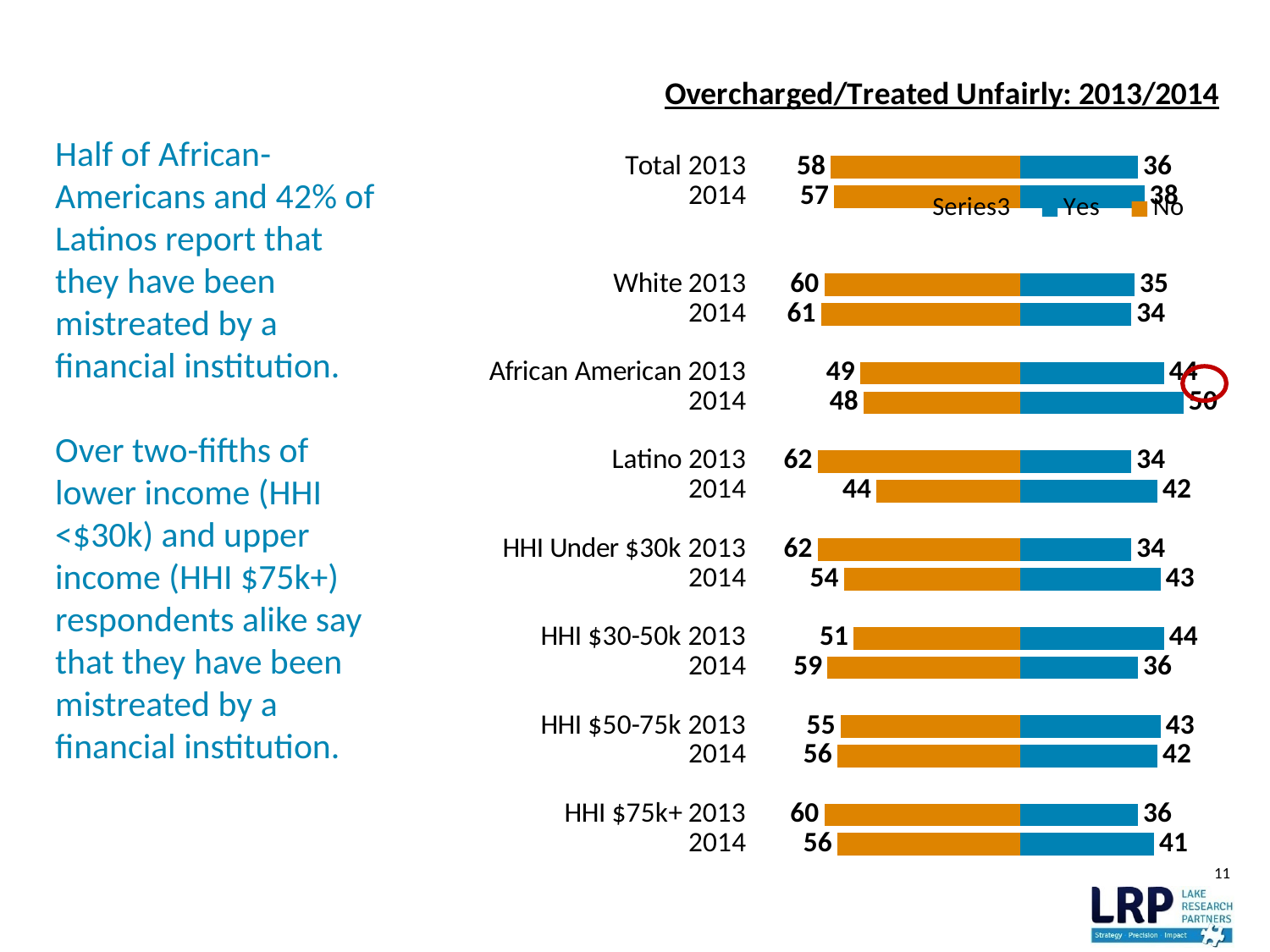
What is the difference between the "Yes" values for HHI Under $30k in 2014 and 2013? 9 How many demographic groups are shown on the chart? 8 What is the difference between the "No" values for Latino 2013 and Latino 2014? 18 What is the "No" value for HHI $75k+ 2014? 56 Which bar has the lowest "No" value? Latino 2014 What colour represents the "No" series? Orange What is the "Yes" value for Latino 2014? 42 What is the "No" value for White 2014? 61 What is the "Yes" value for Total 2013? 36 What kind of chart is shown on the slide? Bar chart How many series does the legend list? 3 For HHI $30-50k, which year has the larger "Yes" value, 2013 or 2014? 2013